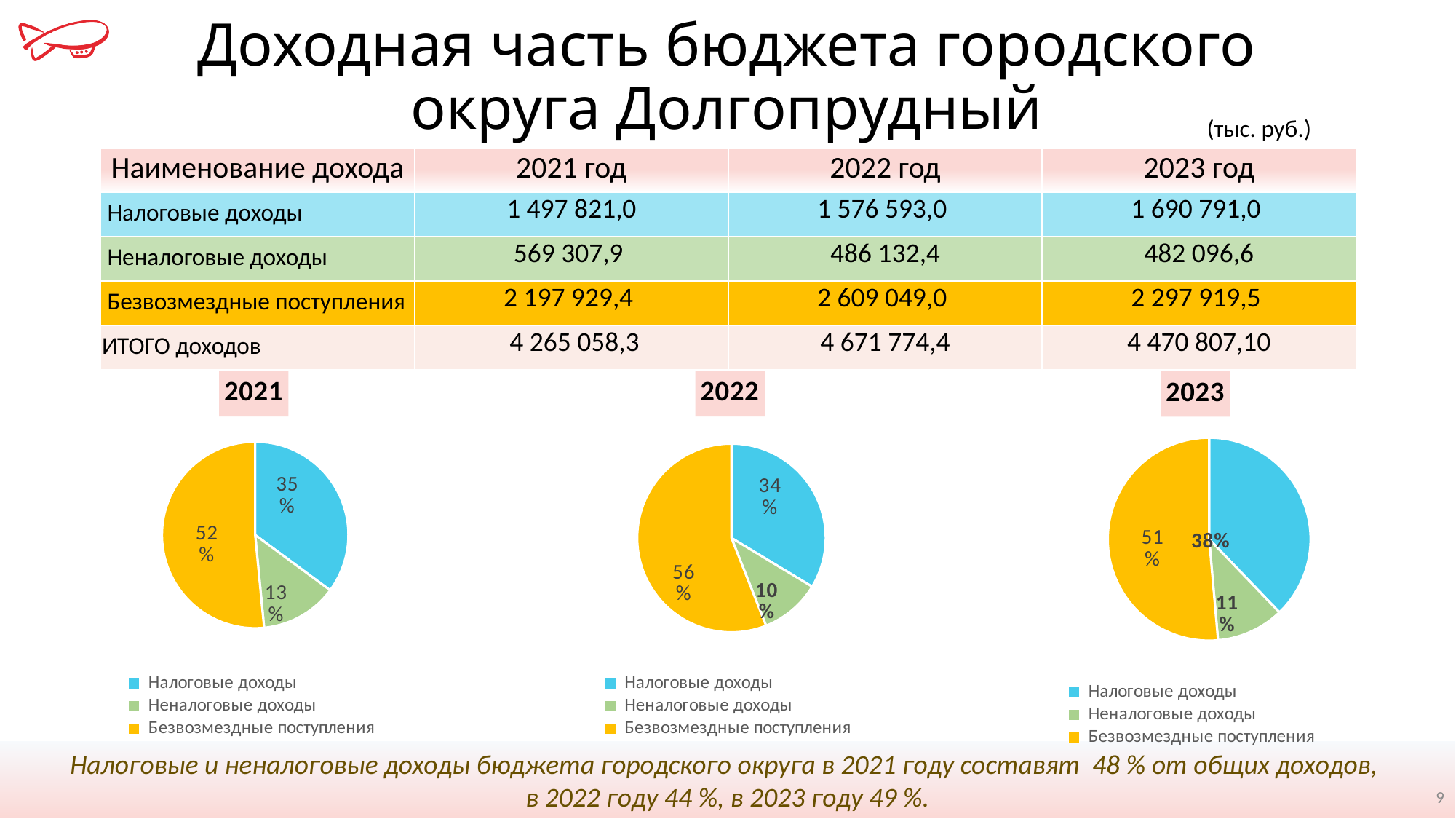
How many entries does the legend of the 2021 chart list? 3 In the 2023 pie chart, what colour is the slice for Безвозмездные поступления? Yellow In the 2022 pie chart, what share is labelled for Неналоговые доходы? 10% In the 2022 pie chart, which category has the smallest slice? Неналоговые доходы In the 2022 pie chart, what share is labelled for Безвозмездные поступления? 56% In the 2023 pie chart, what share is labelled for Неналоговые доходы? 11% In the 2023 pie chart, which category has the largest slice? Безвозмездные поступления How many slices does the 2022 pie chart have? 3 In the 2021 pie chart, what is the difference in percentage points between Безвозмездные поступления and Налоговые доходы? 17 In the 2021 pie chart, what share is labelled for Налоговые доходы? 35% What type of chart is used for the 2021, 2022 and 2023 data below the table? Pie chart Is the share of Налоговые доходы larger in the 2023 pie chart or in the 2022 pie chart? 2023